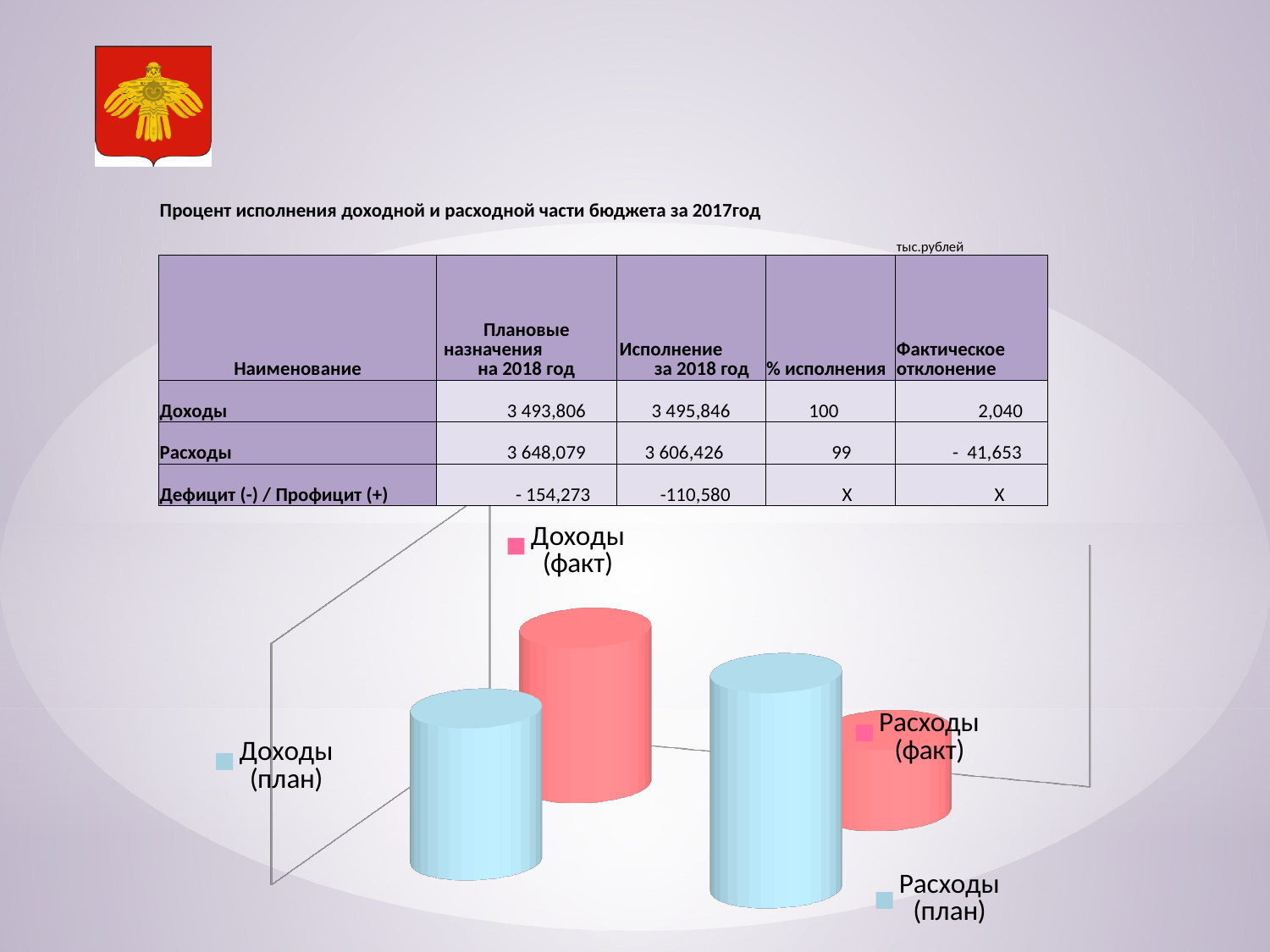
Which two legend entries in the chart are shown in light blue? Доходы (план) and Расходы (план) What kind of chart is shown at the bottom of the slide? bar chart Which legend entry in the chart is labelled at the bottom right? Расходы (план) How many bars are plotted in the chart? 4 What colour is the bar for Доходы (факт) in the chart? pink How many entries does the chart's legend list? 4